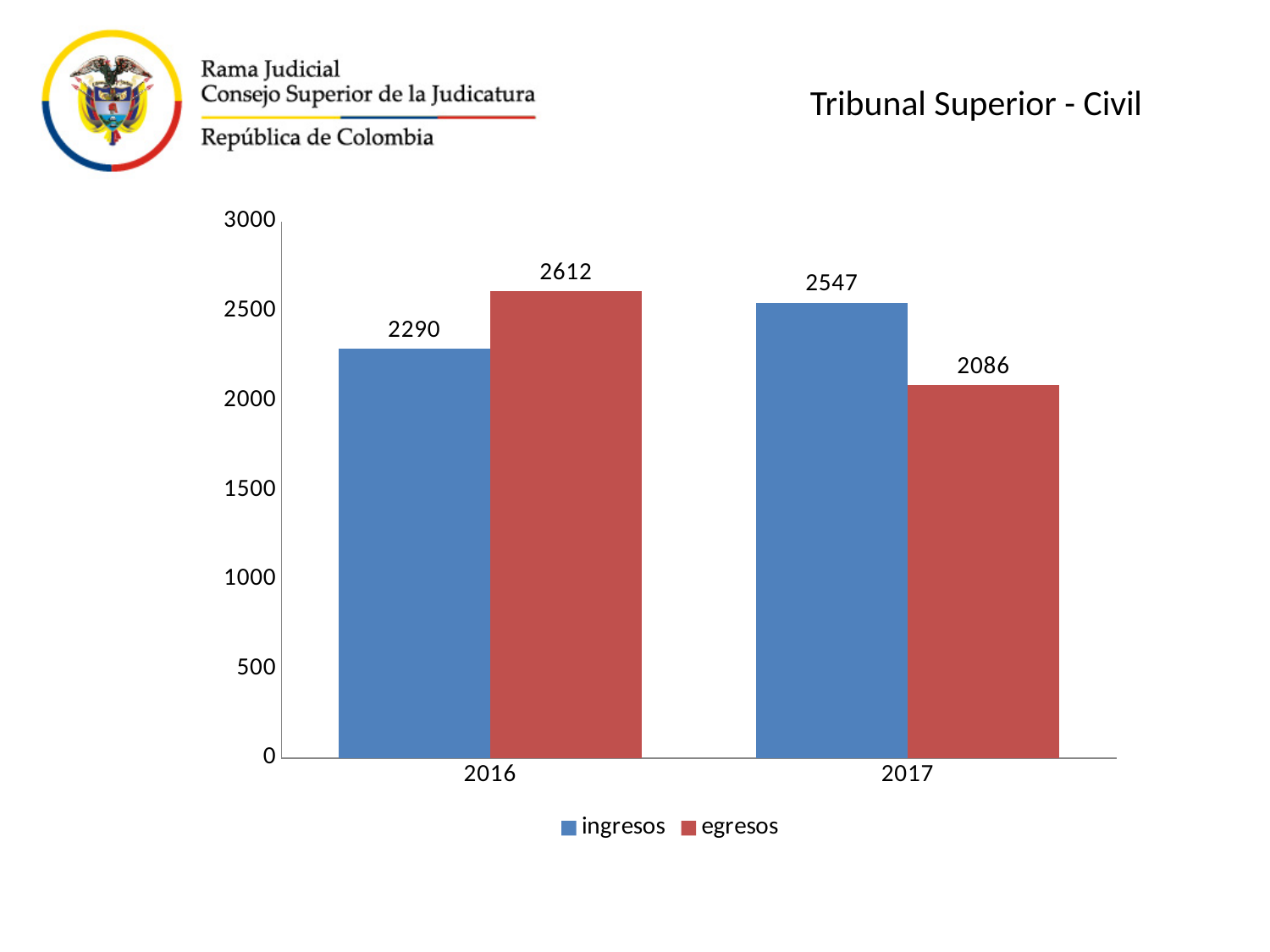
What is the value of ingresos for 2016? 2290 How many series does the legend list? 2 What is the difference between egresos and ingresos in 2016? 322 Which year has the higher value for ingresos? 2017 Do the egresos values rise or fall from 2016 to 2017? fall What is the value of egresos for 2017? 2086 In 2017, which is larger, ingresos or egresos? ingresos Which year has the lower value for egresos? 2017 What is the difference between ingresos and egresos in 2017? 461 What kind of chart is shown on the slide? bar chart What is the value of egresos for 2016? 2612 Is the value of egresos for 2016 greater or less than 2500? greater